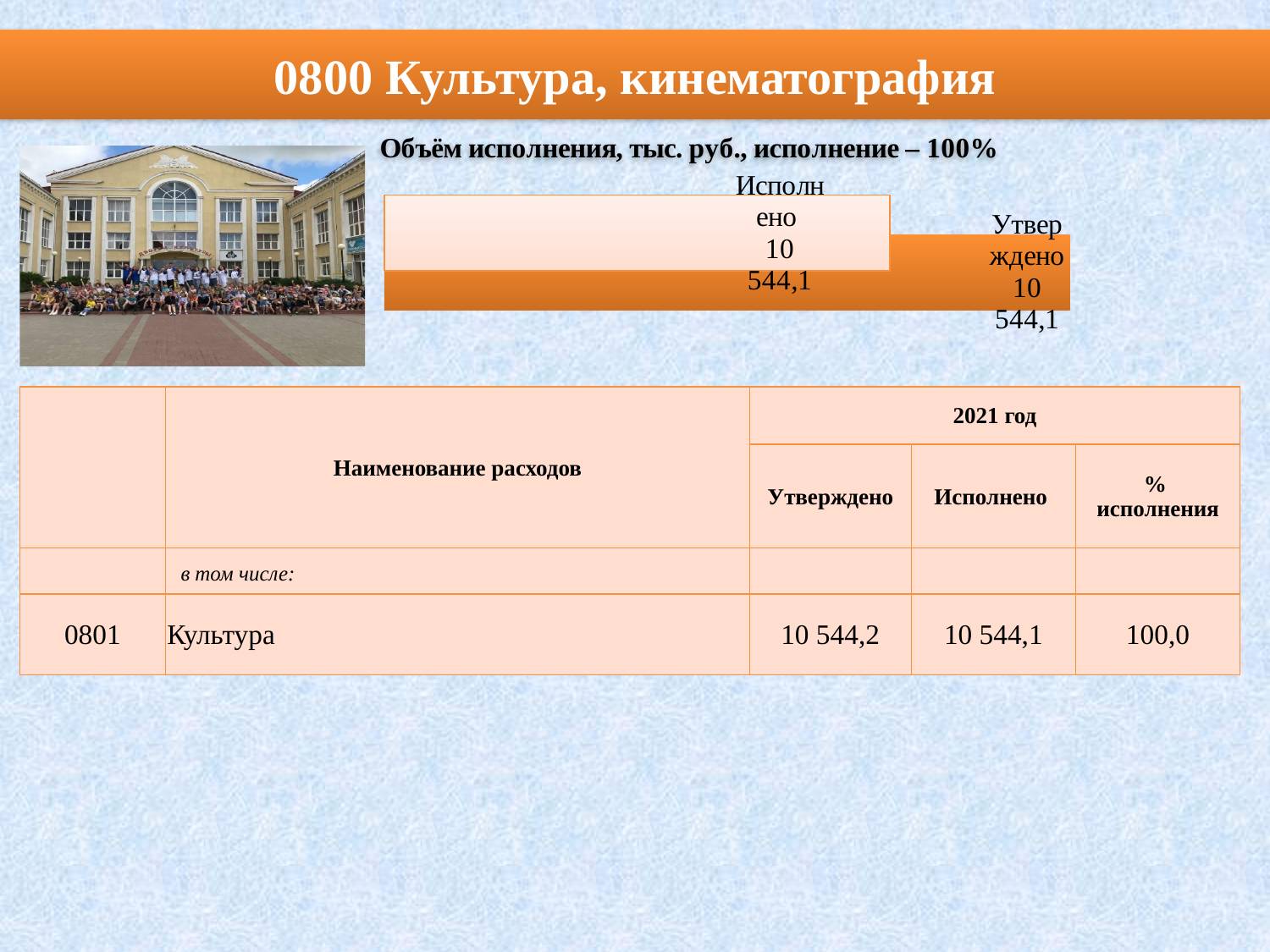
Are the bars in the chart horizontal or vertical? horizontal What value is labelled on the 'Исполнено' bar in the chart? 10 544,1 How many bars does the chart show? 2 Which bar in the chart is coloured dark orange? Утверждено In what units are the values in the chart given, according to its title? тыс. руб. What value is labelled on the 'Утверждено' bar in the chart? 10 544,1 What kind of chart is shown on the slide? bar chart What is the title of the chart? Объём исполнения, тыс. руб., исполнение – 100%